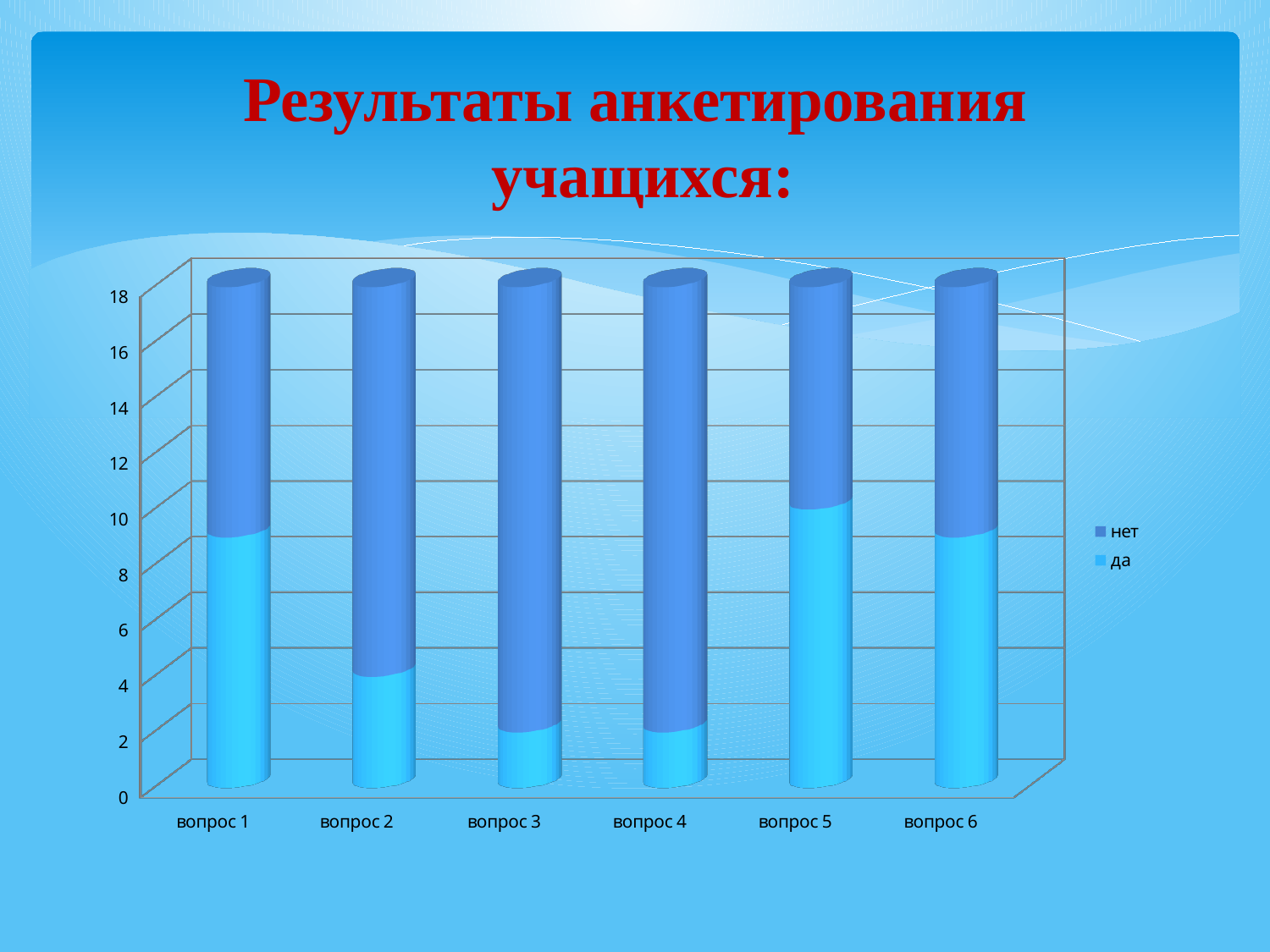
Is the value of 'да' for вопрос 5 greater or less than 8? greater Is the value of 'да' for вопрос 2 greater or less than 6? less How many categories (вопрос) are shown on the x axis? 6 Which has a larger 'да' value, вопрос 5 or вопрос 4? вопрос 5 How many series does the legend list? 2 Is the 'нет' segment for вопрос 3 greater or less than 14? greater What is the title of the slide? Результаты анкетирования учащихся: What are the two series named in the legend? нет, да Which has a larger 'да' value, вопрос 1 or вопрос 2? вопрос 1 What kind of chart is shown on the slide? bar chart